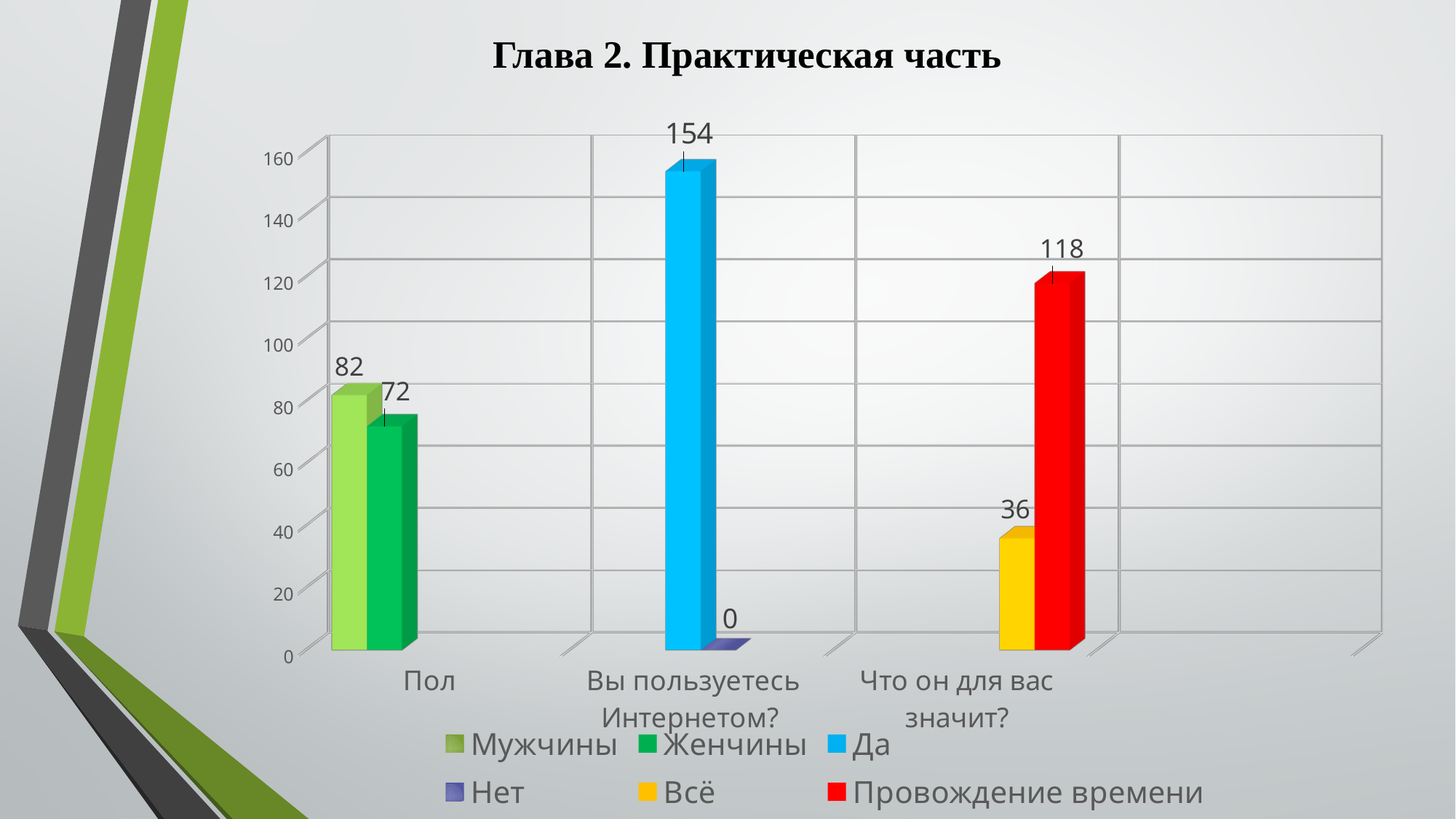
What is the difference between the values for Мужчины and Женчины? 10 What is the value for Женчины in the Пол category? 72 How many series does the legend list? 6 What is the value for Да in the category 'Вы пользуетесь Интернетом?'? 154 What is the value for Мужчины in the Пол category? 82 What is the value for Нет in the category 'Вы пользуетесь Интернетом?'? 0 What is the value for Всё in the category 'Что он для вас значит?'? 36 What kind of chart is shown on the slide? Bar chart Which is larger, the value for Провождение времени or the value for Всё? Провождение времени What is the value for Провождение времени in the category 'Что он для вас значит?'? 118 Which series has the highest value on the chart? Да Which series has the lowest value on the chart? Нет